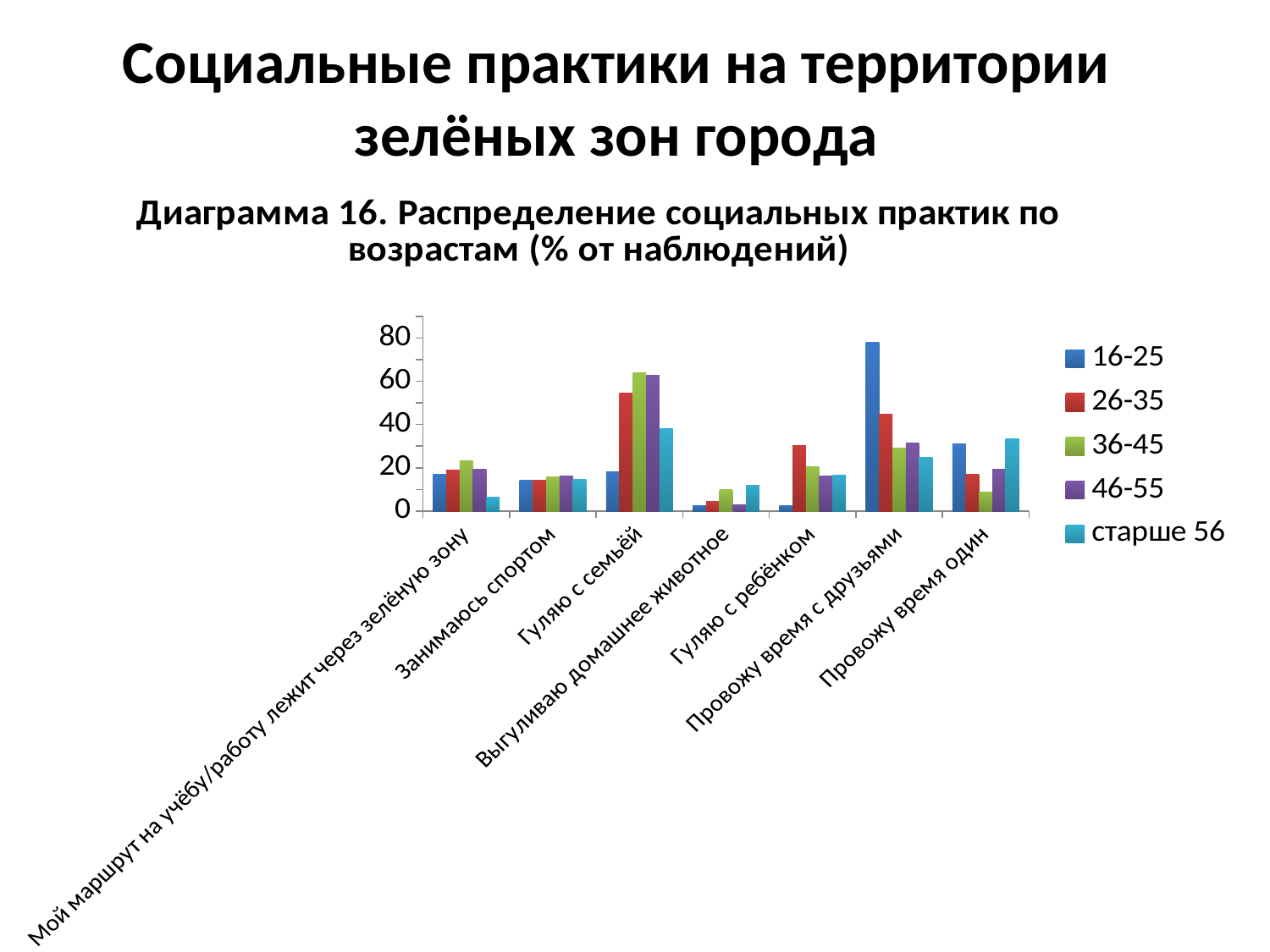
What is the last entry listed in the chart legend? старше 56 Which age group has the highest bar in the category "Гуляю с ребёнком"? 26-35 Is the value for the 16-25 series in the category "Гуляю с ребёнком" greater or less than 20? less How many categories are shown on the x axis of the chart? 7 What kind of chart is shown on the slide? bar chart Which age group has the highest bar in the category "Провожу время с друзьями"? 16-25 Is the value for the 36-45 series in the category "Провожу время один" greater or less than 20? less Which age group has the lowest bar in the category "Гуляю с ребёнком"? 16-25 In the category "Гуляю с семьёй", which is larger: the value for 26-35 or the value for старше 56? 26-35 Is the value for the 16-25 series in the category "Провожу время с друзьями" greater or less than 60? greater How many series does the legend list? 5